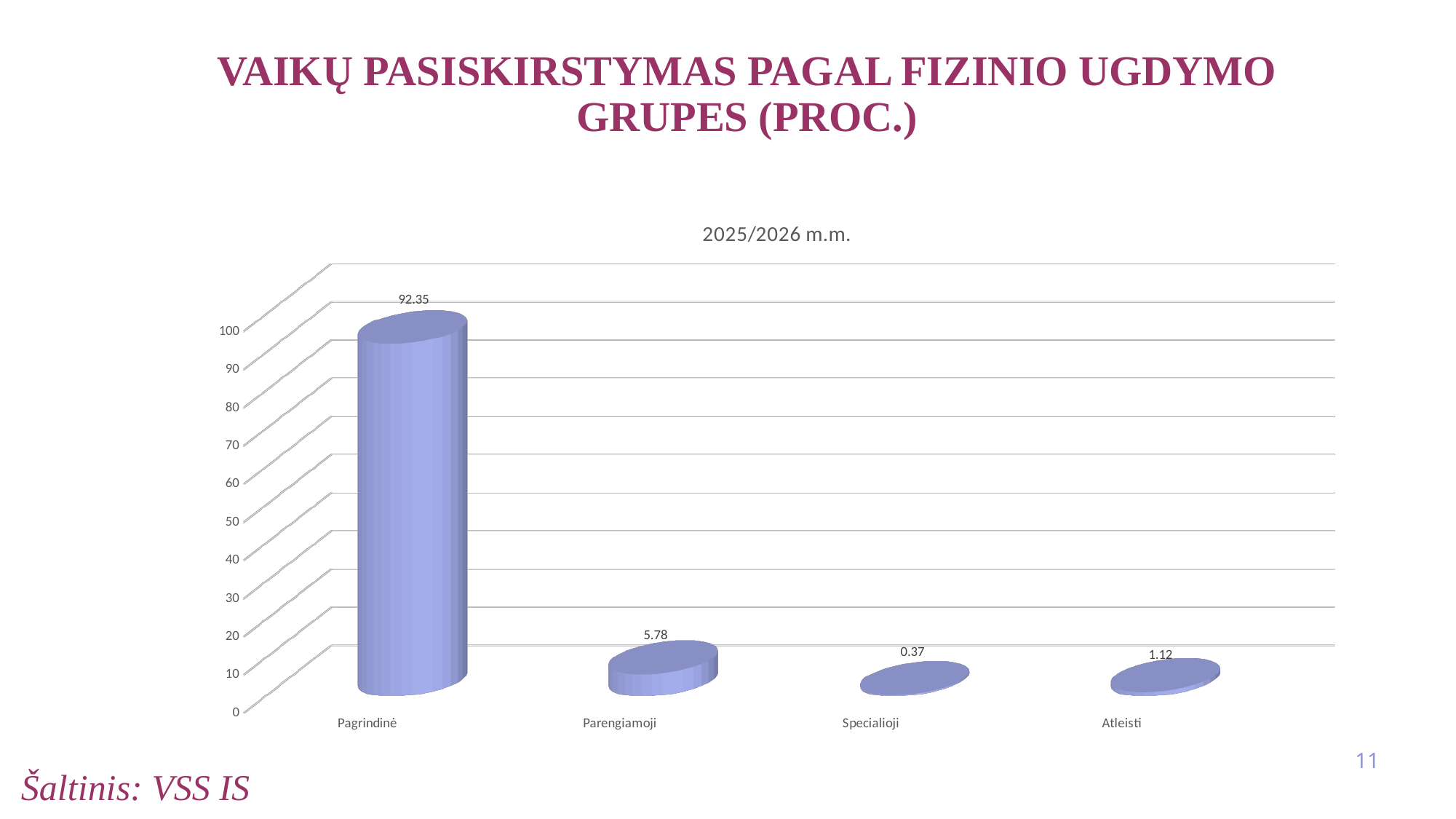
Which category has the lowest value? Specialioji What is the title shown above the chart? 2025/2026 m.m. What kind of chart is shown? bar chart Is the value for Pagrindinė greater or less than 90? greater How many categories are shown on the x axis? 4 What is the value for Specialioji? 0.37 Which category has the highest value? Pagrindinė What is the difference between the values for Pagrindinė and Parengiamoji? 86.57 Which is larger, the value for Atleisti or the value for Specialioji? Atleisti What is the value for Pagrindinė? 92.35 What is the value for Atleisti? 1.12 What is the value for Parengiamoji? 5.78